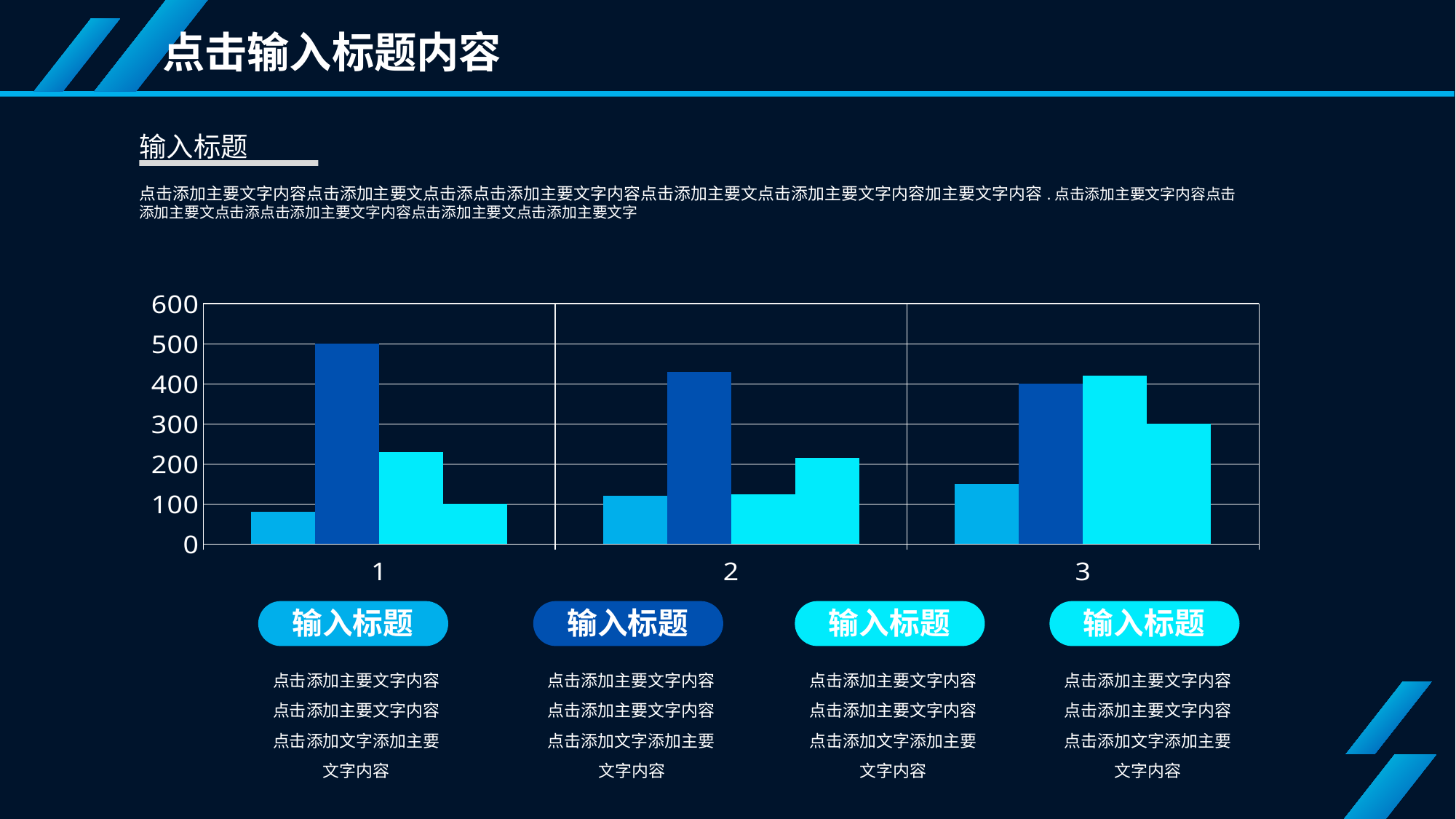
How many categories are shown on the x axis of the chart? 3 How many bars are plotted in each category group of the chart? 4 What is the value of the dark blue bar in category 1? 500 Which category contains the tallest bar in the chart? 1 Is the value of the third (cyan) bar in category 3 greater or less than 400? greater Is the value of the first (light blue) bar in category 1 greater or less than 100? less Which is larger: the dark blue bar in category 1 or the dark blue bar in category 2? category 1 What is the difference between the dark blue bar in category 1 and the dark blue bar in category 3? 100 What is the value of the dark blue bar in category 3? 400 What kind of chart is shown on the slide? bar chart Does the first (light blue) bar rise or fall from category 1 to category 3? rises Is the value of the dark blue bar in category 2 greater or less than 400? greater